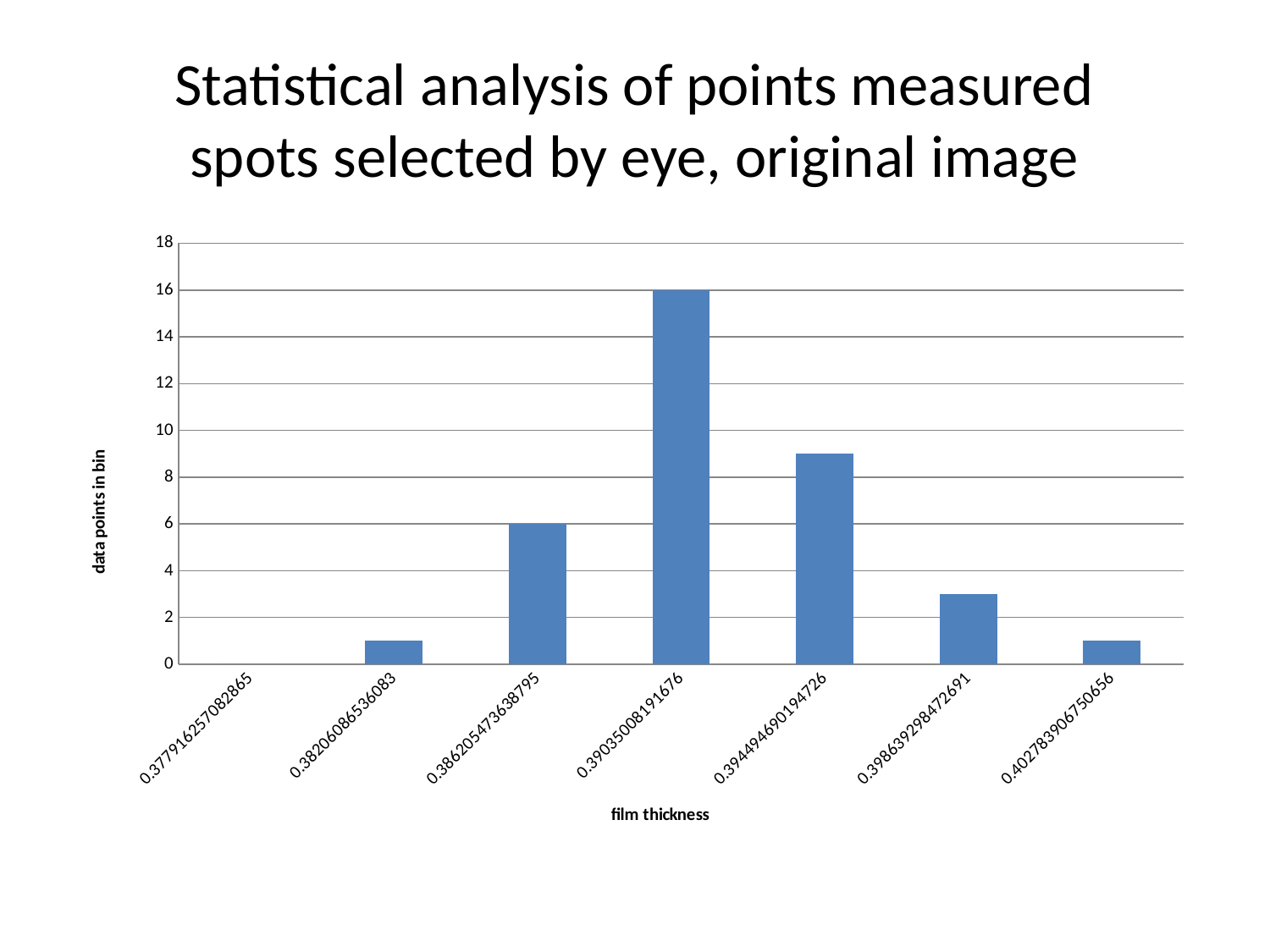
What is the difference in data points between the bin 0.39035008191676 and the bin 0.386205473638795? 10 What is the title of the y axis? data points in bin Is the value for the bin 0.398639298472691 greater or less than 4? less How many data points are in the bin 0.386205473638795? 6 How many data points are in the bin 0.39035008191676? 16 What kind of chart is shown on the slide? bar chart How many film thickness bins are shown on the x axis? 7 What is the title of the x axis? film thickness Is the value for the bin 0.394494690194726 greater or less than 8? greater Is the value for the bin 0.38206086536083 greater or less than 2? less Which film thickness bin has the highest number of data points? 0.39035008191676 Which bin has more data points, 0.386205473638795 or 0.394494690194726? 0.394494690194726